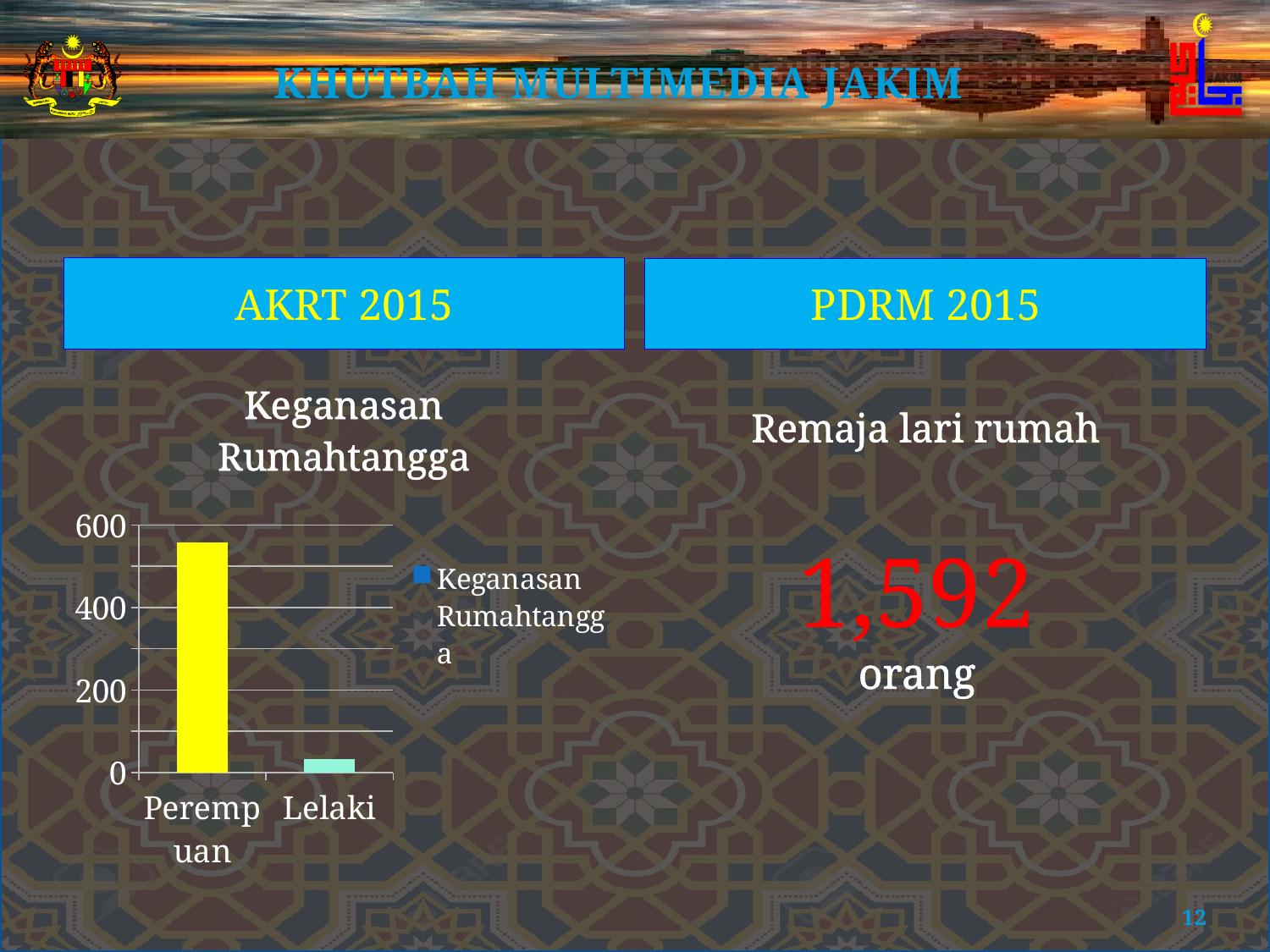
In the Keganasan Rumahtangga chart, is the value for Perempuan greater or less than 400? greater Which category has the lowest value in the Keganasan Rumahtangga chart? Lelaki In the Keganasan Rumahtangga chart, is the value for Lelaki greater or less than 200? less In the Keganasan Rumahtangga chart, is the value for Perempuan greater or less than 600? less How many categories are shown on the x axis of the Keganasan Rumahtangga chart? 2 Which category has the highest value in the Keganasan Rumahtangga chart? Perempuan In the Keganasan Rumahtangga chart, which is larger, the value for Perempuan or the value for Lelaki? Perempuan What kind of chart is shown under the AKRT 2015 heading? bar chart How many series does the legend of the Keganasan Rumahtangga chart list? 1 What is the title of the chart on the left side of the slide? Keganasan Rumahtangga What is the highest value shown on the y axis of the Keganasan Rumahtangga chart? 600